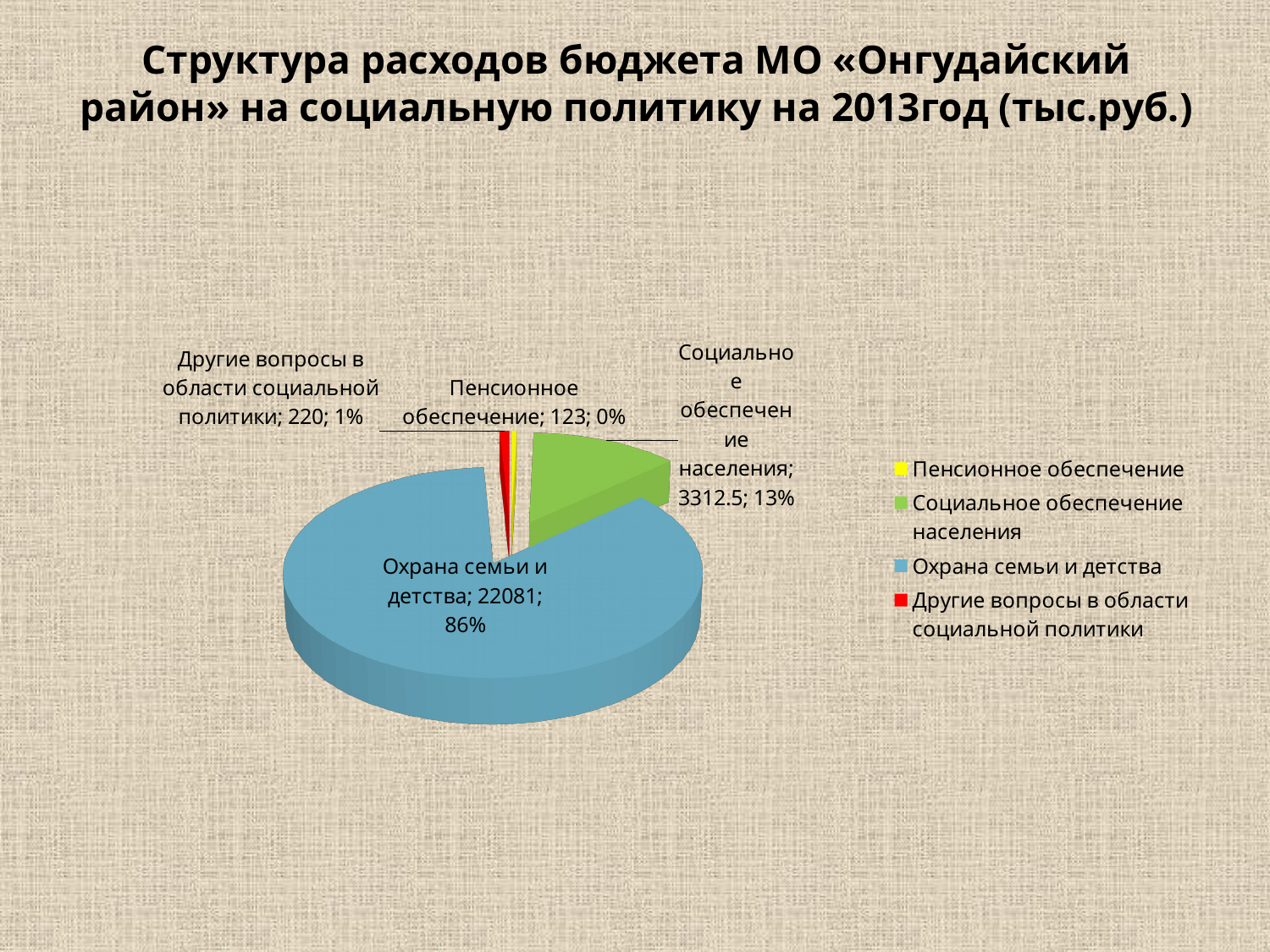
What is the value for Охрана семьи и детства? 22081 How many categories does the pie chart have? 4 Which category has the largest slice of the pie? Охрана семьи и детства What is the difference between the values for Другие вопросы в области социальной политики and Пенсионное обеспечение? 97 Which category has the smallest slice of the pie? Пенсионное обеспечение Which colour represents Социальное обеспечение населения in the legend? Green What share of the pie does Социальное обеспечение населения represent? 13% What is the value for Другие вопросы в области социальной политики? 220 What share of the pie does Охрана семьи и детства represent? 86% What is the value for Социальное обеспечение населения? 3312.5 What is the value for Пенсионное обеспечение? 123 What kind of chart is shown on the slide? Pie chart